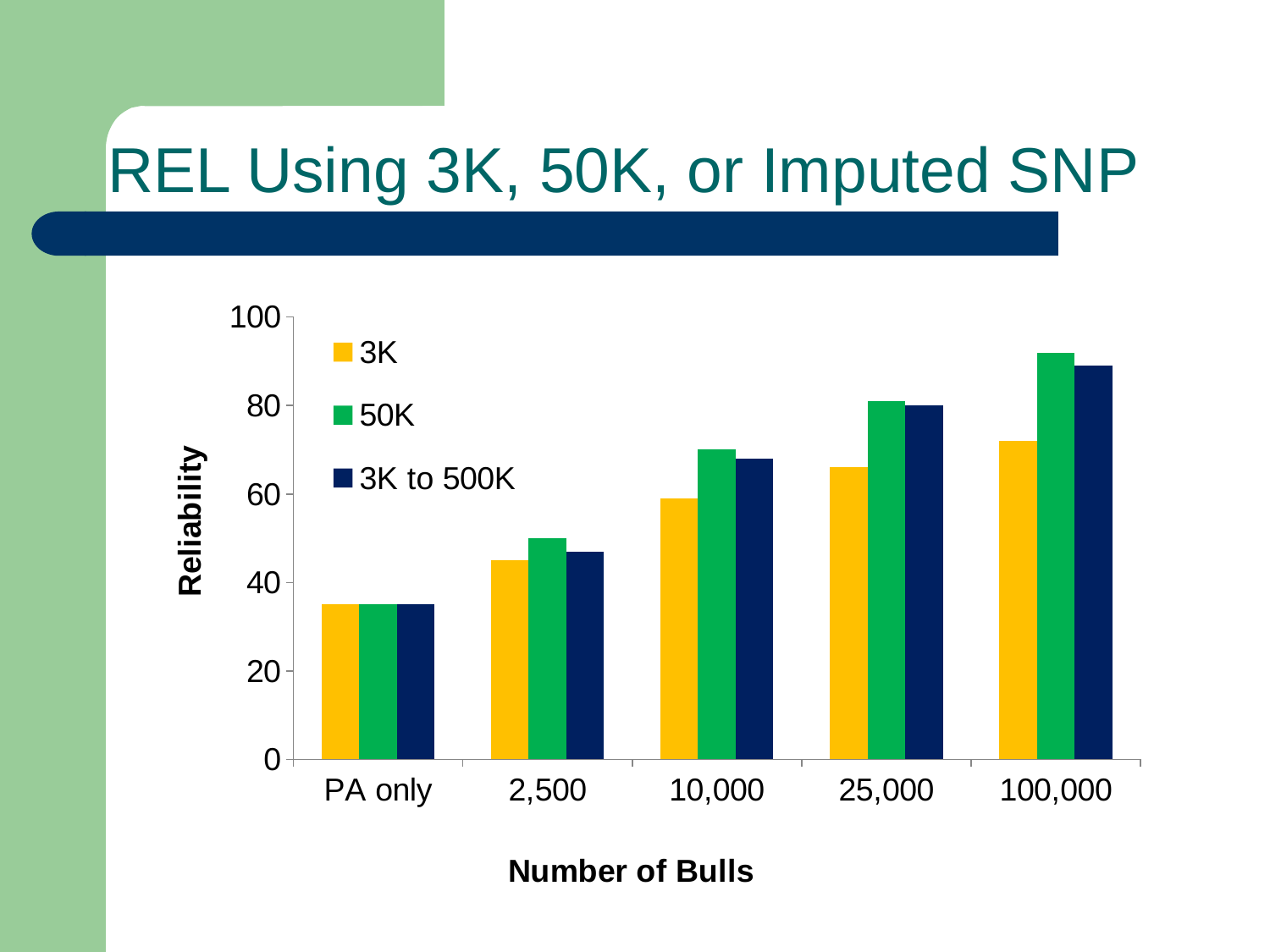
Is the 3K to 500K value for 25,000 bulls greater or less than 60? greater How many series does the legend list? 3 Is the 3K value for PA only greater or less than 40? less Does the 3K series rise or fall as the number of bulls increases along the x axis? rise Is the 3K value for 100,000 bulls greater or less than 60? greater What kind of chart is shown on the slide? bar chart Which number of bulls has the lowest 3K reliability? PA only Which number of bulls has the highest 50K reliability? 100,000 How many categories are shown on the x axis? 5 For 25,000 bulls, which is larger: the 3K value or the 3K to 500K value? 3K to 500K